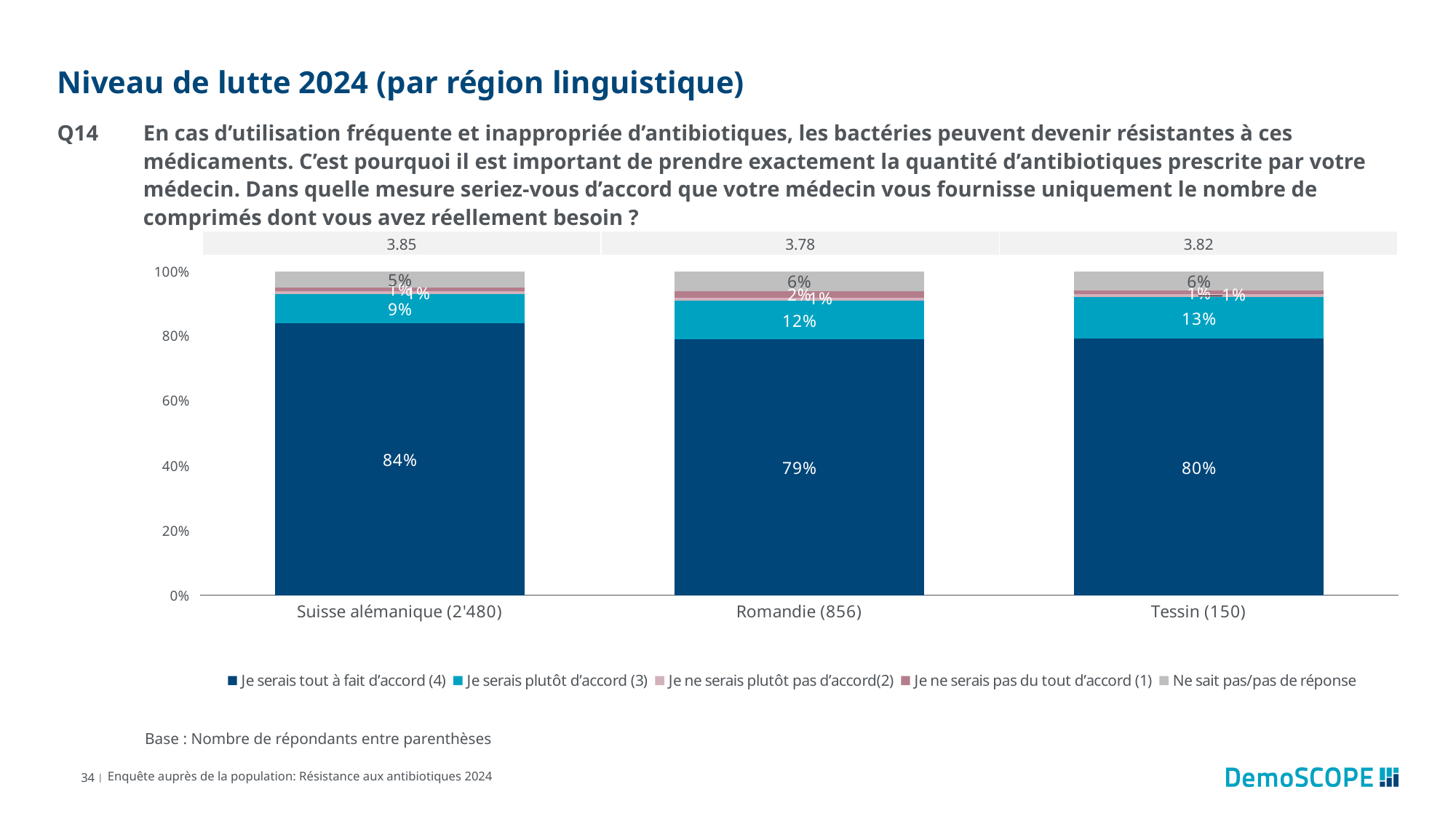
What type of chart is shown on the slide? Stacked bar chart What percentage of respondents in Suisse alémanique (2'480) answered "Je serais tout à fait d'accord (4)"? 84% What percentage of respondents in Romandie (856) answered "Je serais plutôt d'accord (3)"? 12% How many response categories does the legend list? 5 Which region has a larger share of "Je serais plutôt d'accord (3)" responses, Romandie (856) or Tessin (150)? Tessin (150) How many regions (categories) are shown on the x axis of the chart? 3 What percentage of respondents in Tessin (150) answered "Ne sait pas/pas de réponse"? 6% What is the difference in percentage points between the "Je serais tout à fait d'accord (4)" share in Suisse alémanique (2'480) and in Romandie (856)? 5 percentage points Which region has the lowest share of "Je serais plutôt d'accord (3)" responses? Suisse alémanique (2'480) What is the mean score shown above the bar for Romandie (856)? 3.78 Which region has the highest share of "Je serais tout à fait d'accord (4)" responses? Suisse alémanique (2'480) Which region has the highest mean score shown above the bars? Suisse alémanique (2'480)